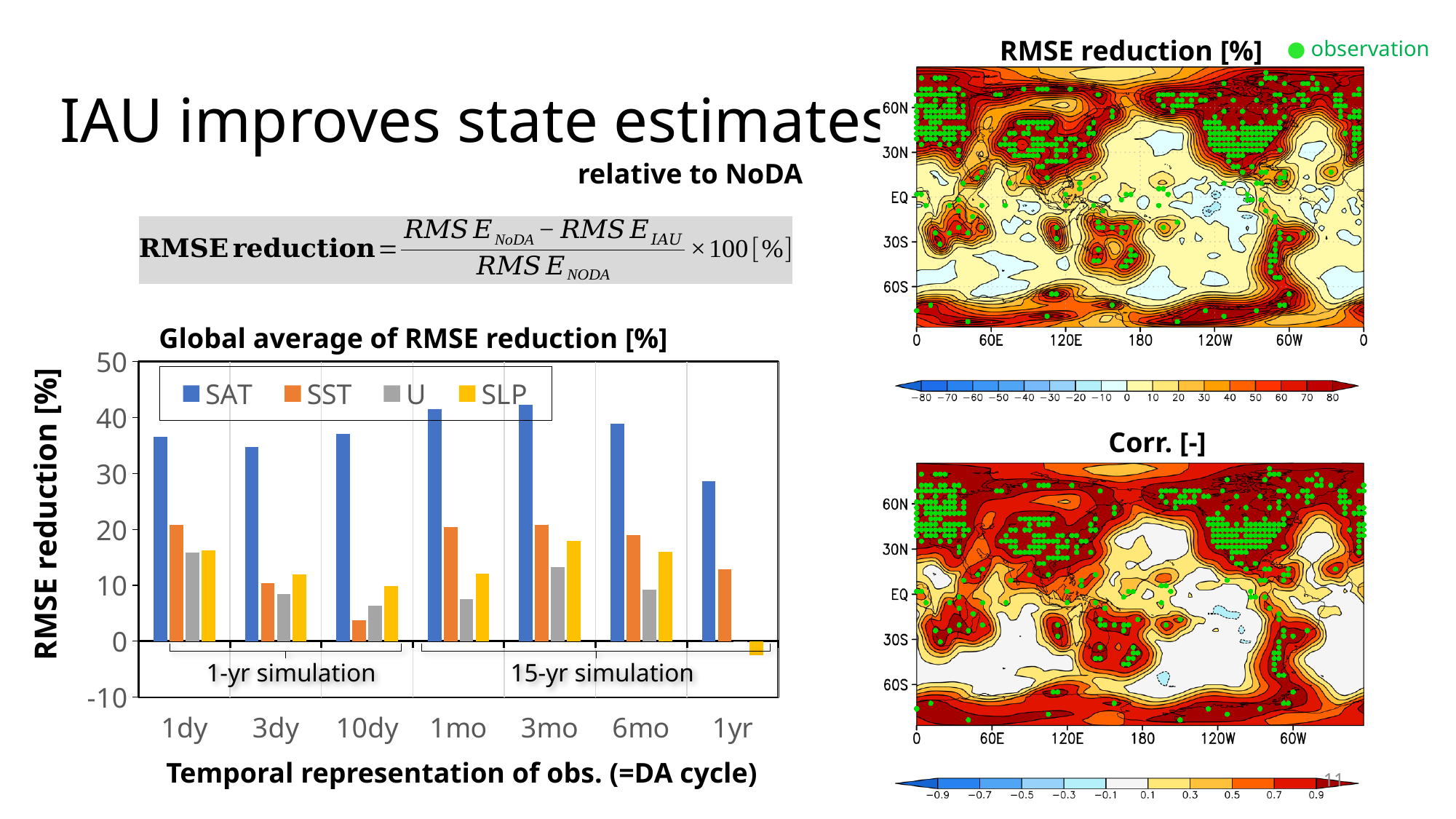
What kind of chart is 'Global average of RMSE reduction [%]'? bar chart How many categories are shown on the x axis of the 'Global average of RMSE reduction [%]' chart? 7 In the 'Global average of RMSE reduction [%]' chart, which series has the highest value at 1dy? SAT In the 'Global average of RMSE reduction [%]' chart, is the U value larger at 1dy or at 3dy? 1dy In the 'Global average of RMSE reduction [%]' chart, does the SST value rise or fall from 1dy to 10dy? fall In the 'Global average of RMSE reduction [%]' chart, which series has the lowest value at 10dy? SST In the 'Global average of RMSE reduction [%]' chart, is the SLP value at 1yr greater or less than 0? less In the 'Global average of RMSE reduction [%]' chart, is the SST value at 10dy greater or less than 10? less In the 'Global average of RMSE reduction [%]' chart, is the SAT value at 1dy greater or less than 30? greater How many series does the legend of the 'Global average of RMSE reduction [%]' chart list? 4 In the 'Global average of RMSE reduction [%]' chart, which is larger at 1dy: SAT or SST? SAT What is the x-axis label of the 'Global average of RMSE reduction [%]' chart? Temporal representation of obs. (=DA cycle)